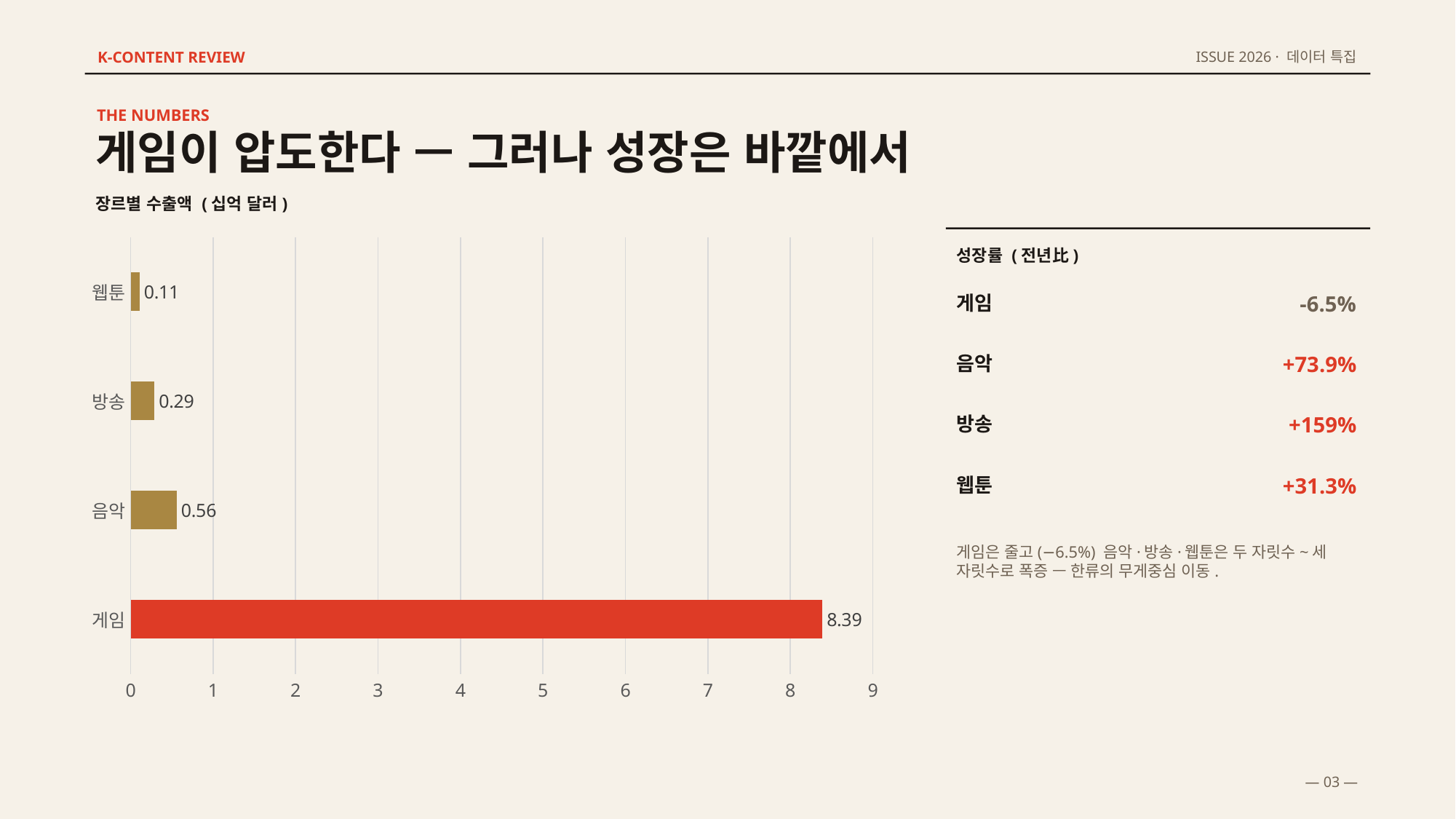
What kind of chart is shown on the slide? bar chart What is the difference between the values for 게임 and 음악? 7.83 Which category has the lowest value in the chart? 웹툰 What is the value for 방송 in the chart? 0.29 Is the value for 게임 greater or less than 8? greater What is the value for 웹툰 in the chart? 0.11 Which is larger, the value for 음악 or the value for 방송? 음악 What is the value for 게임 in the chart? 8.39 Which category has the highest value in the chart? 게임 How many categories are shown in the chart? 4 What is the value for 음악 in the chart? 0.56 What is the difference between the values for 방송 and 웹툰? 0.18